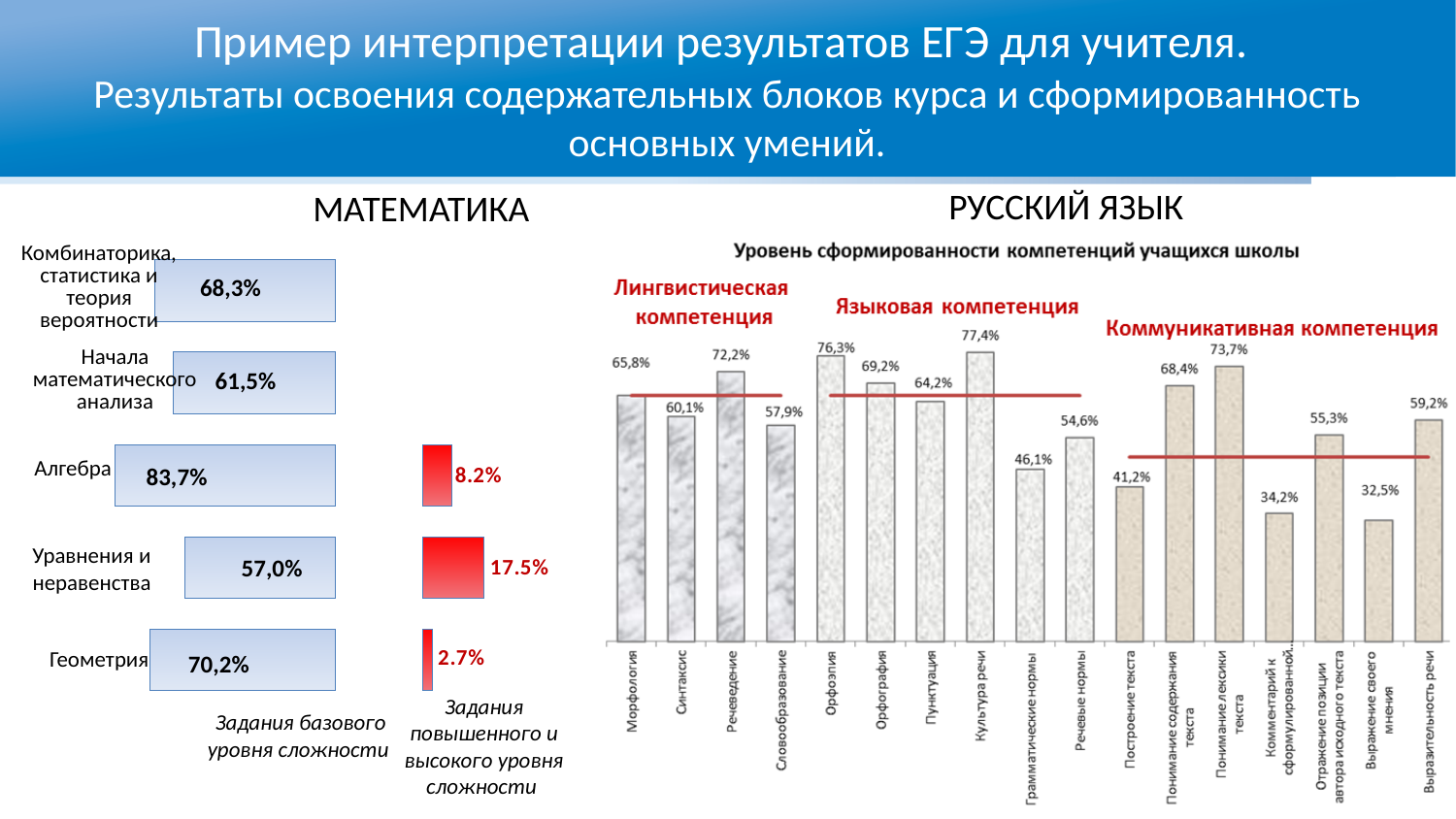
On the РУССКИЙ ЯЗЫК chart, what is the value for Культура речи? 77,4% On the РУССКИЙ ЯЗЫК chart, what is the value for Построение текста? 41,2% On the РУССКИЙ ЯЗЫК chart, which category has the highest value? Культура речи On the МАТЕМАТИКА chart, which content block has the lowest value for basic-level tasks? Уравнения и неравенства On the РУССКИЙ ЯЗЫК chart, which category has the lowest value? Выражение своего мнения On the РУССКИЙ ЯЗЫК chart, which is larger: Речеведение or Словообразование? Речеведение On the МАТЕМАТИКА chart, what is the value for Уравнения и неравенства for tasks of the advanced and high level (Задания повышенного и высокого уровня сложности)? 17.5% On the РУССКИЙ ЯЗЫК chart, how many categories are plotted? 17 On the РУССКИЙ ЯЗЫК chart, what is the difference between Орфоэпия and Орфография? 7,1% What is the title of the РУССКИЙ ЯЗЫК chart? Уровень сформированности компетенций учащихся школы What kind of chart is the РУССКИЙ ЯЗЫК chart? bar chart On the МАТЕМАТИКА chart, what is the value for Алгебра for tasks of the basic level of difficulty (Задания базового уровня сложности)? 83,7%